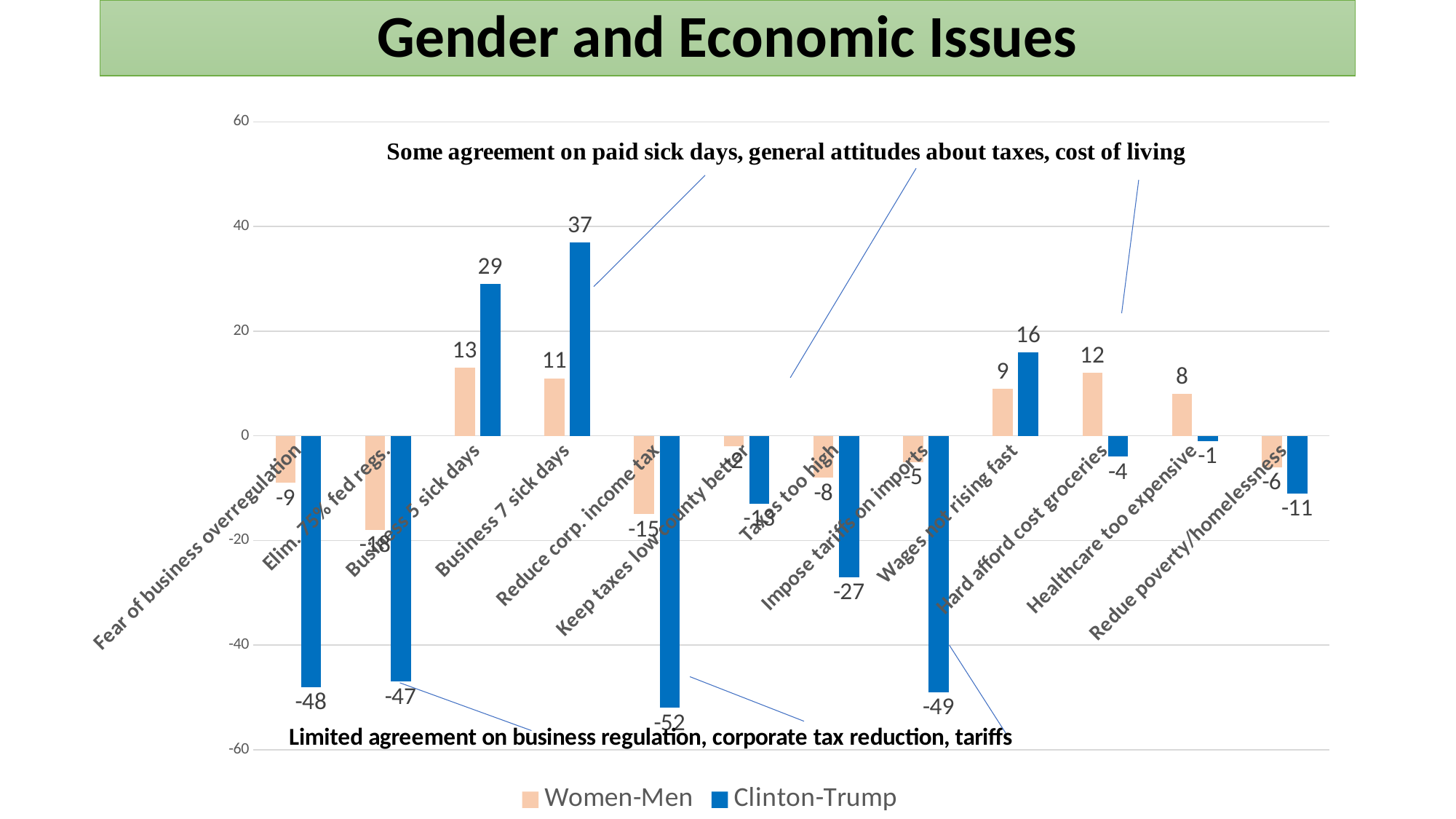
What is the Clinton-Trump value for Impose tariffs on imports? -49 What is the Clinton-Trump value for Business 7 sick days? 37 What is the Women-Men value for Reduce corp. income tax? -15 What is the difference between the Clinton-Trump and Women-Men values for Business 7 sick days? 26 Which category has the highest Clinton-Trump value? Business 7 sick days Is the Clinton-Trump value for Keep taxes low county better greater or less than -20? greater How many series does the legend list? 2 How many categories are shown on the x axis? 12 What is the Women-Men value for Hard afford cost groceries? 12 Which is larger for Wages not rising fast: the Women-Men value or the Clinton-Trump value? Clinton-Trump Which category has the lowest Clinton-Trump value? Reduce corp. income tax What kind of chart is shown on the slide? bar chart